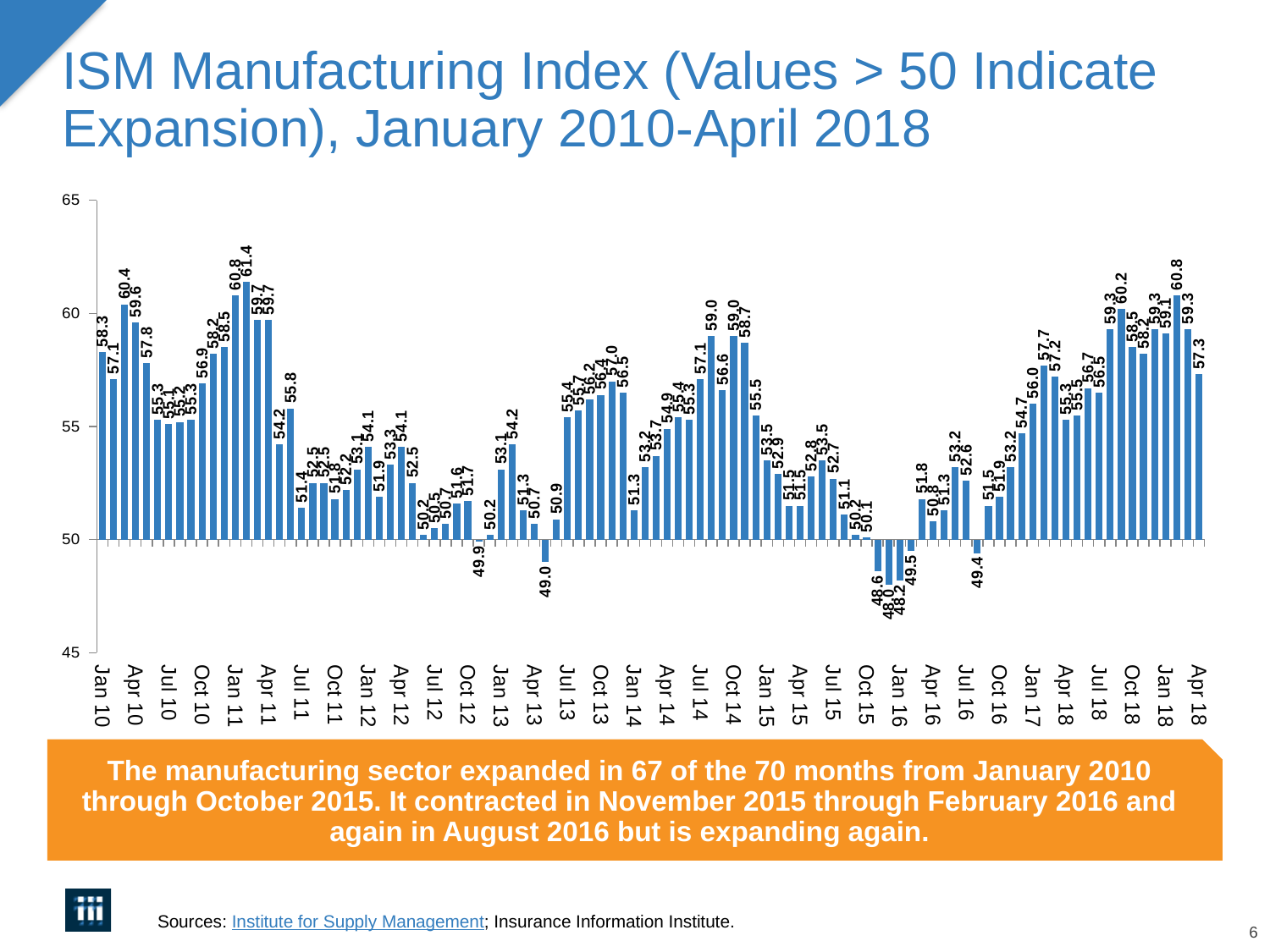
What is the ISM Manufacturing Index value for Jan 17? 56.0 Is the value for Jan 16 greater or less than 50? less According to the chart title, values above what number indicate expansion? 50 What is the ISM Manufacturing Index value for Oct 15? 50.1 What is the lowest value shown on the chart? 48.0 What kind of chart is shown on the slide? Bar chart What is the ISM Manufacturing Index value for Jan 11? 60.8 What is the difference between the values for Jan 11 and Jan 10? 2.5 What is the ISM Manufacturing Index value for Jan 10? 58.3 Which is larger, the value for Jan 10 or the value for Jan 11? Jan 11 What is the highest value shown on the chart? 61.4 Is the value for Jan 11 greater or less than 60? greater